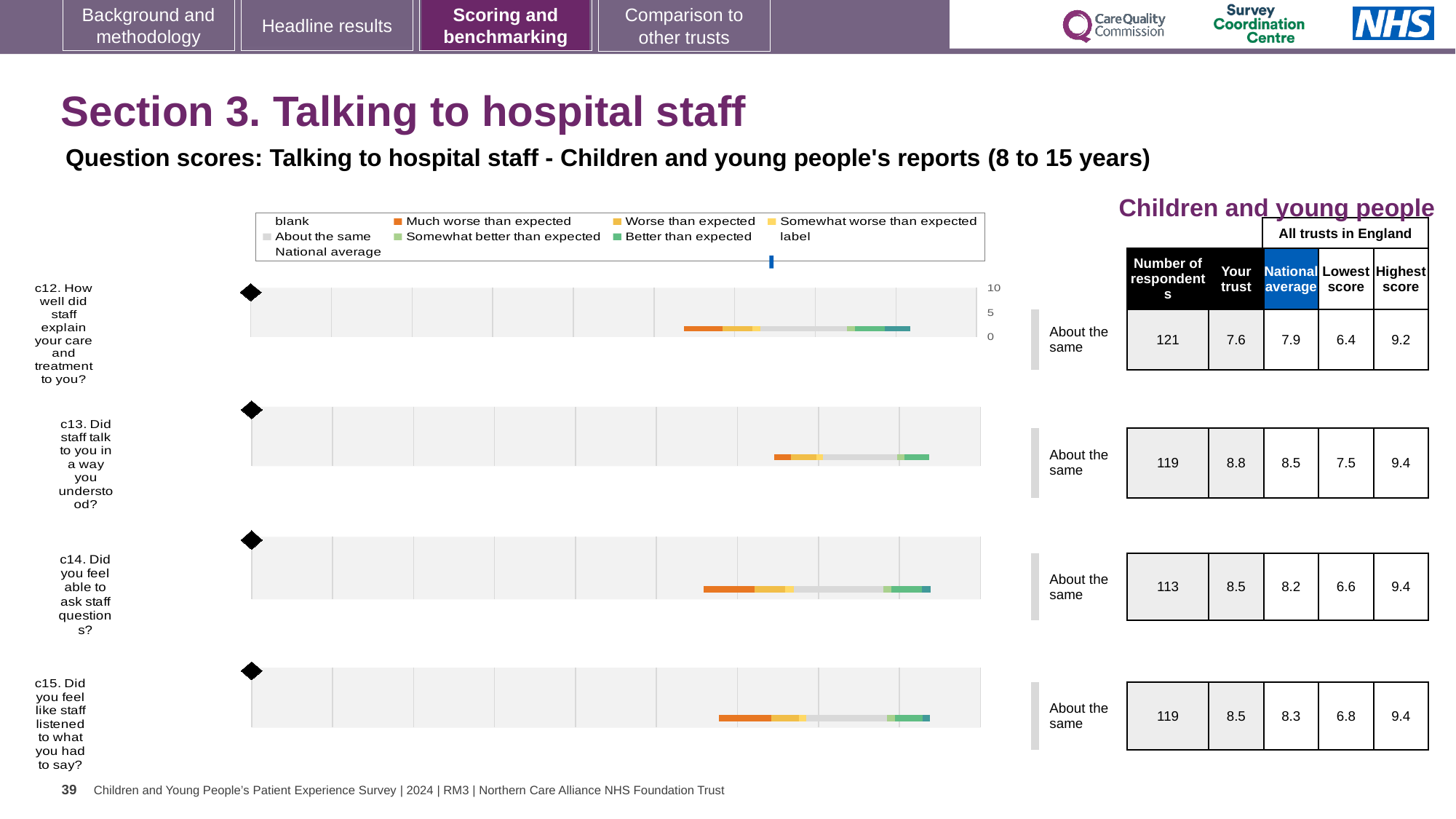
What is the difference between the 'Your trust' score and the national average for c13? 0.3 How many questions (c12 to c15) are plotted on the slide? 4 What is the 'Your trust' score for c13 (Did staff talk to you in a way you understood?)? 8.8 Which question has the lowest 'Your trust' score? c12 How many entries does the chart legend list? 9 What is the lowest score among all trusts in England for c15 (Did you feel like staff listened to what you had to say?)? 6.8 How many respondents answered c14 (Did you feel able to ask staff questions?)? 113 What is the national average score for c12 (How well did staff explain your care and treatment to you?)? 7.9 What kind of chart is used to show the question scores for c12 to c15? bar chart Which question has the highest 'Your trust' score? c13 What benchmark label is shown next to each of the four question charts? About the same For c14, which is larger: the 'Your trust' score or the national average? Your trust